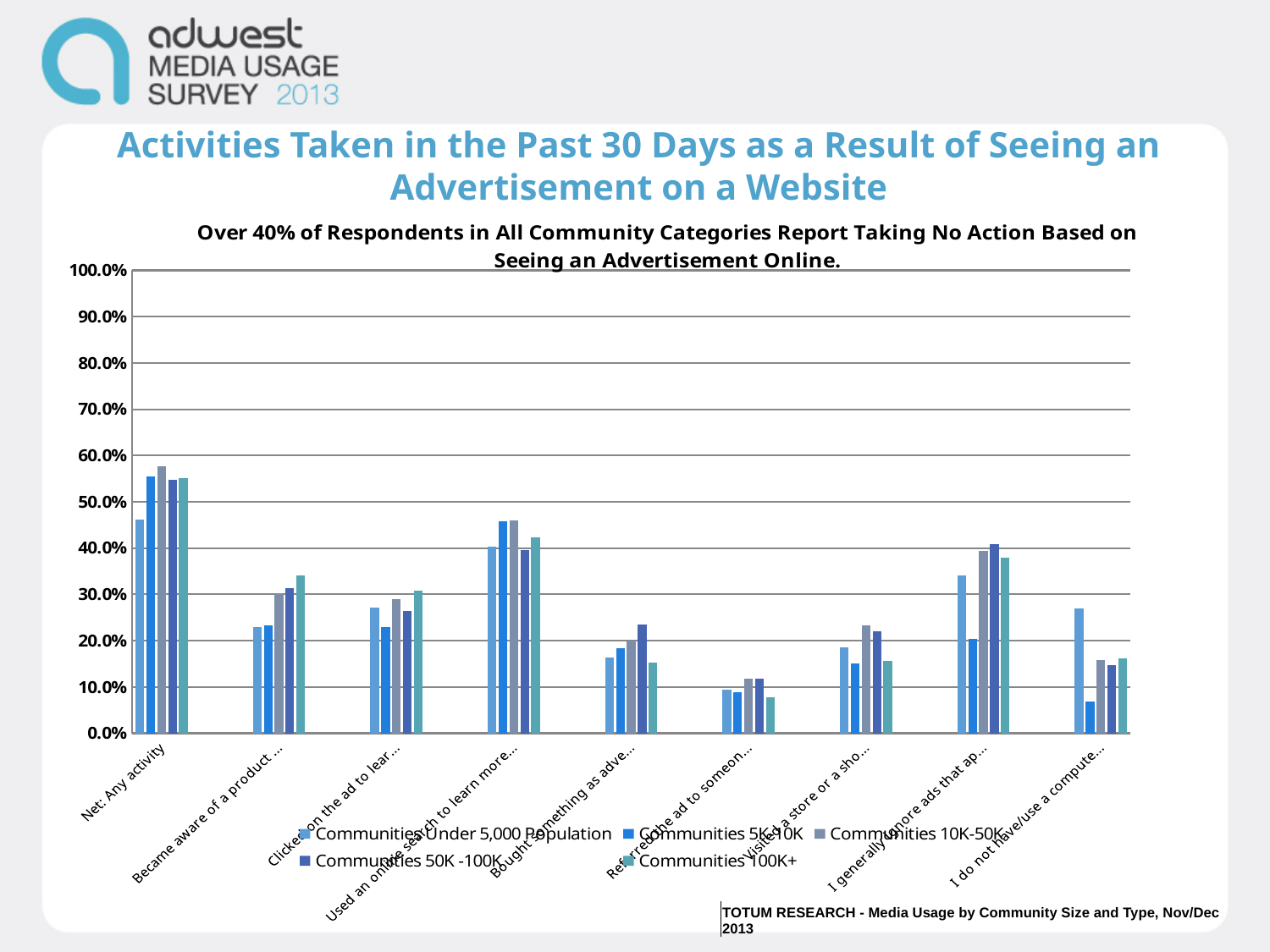
For "Net: Any activity", which is larger: the value for Communities Under 5,000 Population or for Communities 10K-50K? Communities 10K-50K Is the value for "Net: Any activity" for Communities Under 5,000 Population greater or less than 40%? greater Is the value for "Referred the ad to someone" for Communities 100K+ greater or less than 10%? less For "Became aware of a product", which is larger: the value for Communities 100K+ or for Communities Under 5,000 Population? Communities 100K+ How many series does the legend list? 5 Which activity category has the lowest values across all community series? Referred the ad to someone What kind of chart is shown on the slide? bar chart Within the "I do not have/use a computer" category, which community series has the highest value? Communities Under 5,000 Population What is the chart's title text above the plot area? Over 40% of Respondents in All Community Categories Report Taking No Action Based on Seeing an Advertisement Online. Within the "I do not have/use a computer" category, which community series has the lowest value? Communities 5K-10K Is the value for "I generally ignore ads that appear" for Communities 5K-10K greater or less than 30%? less How many activity categories are plotted along the x axis? 9